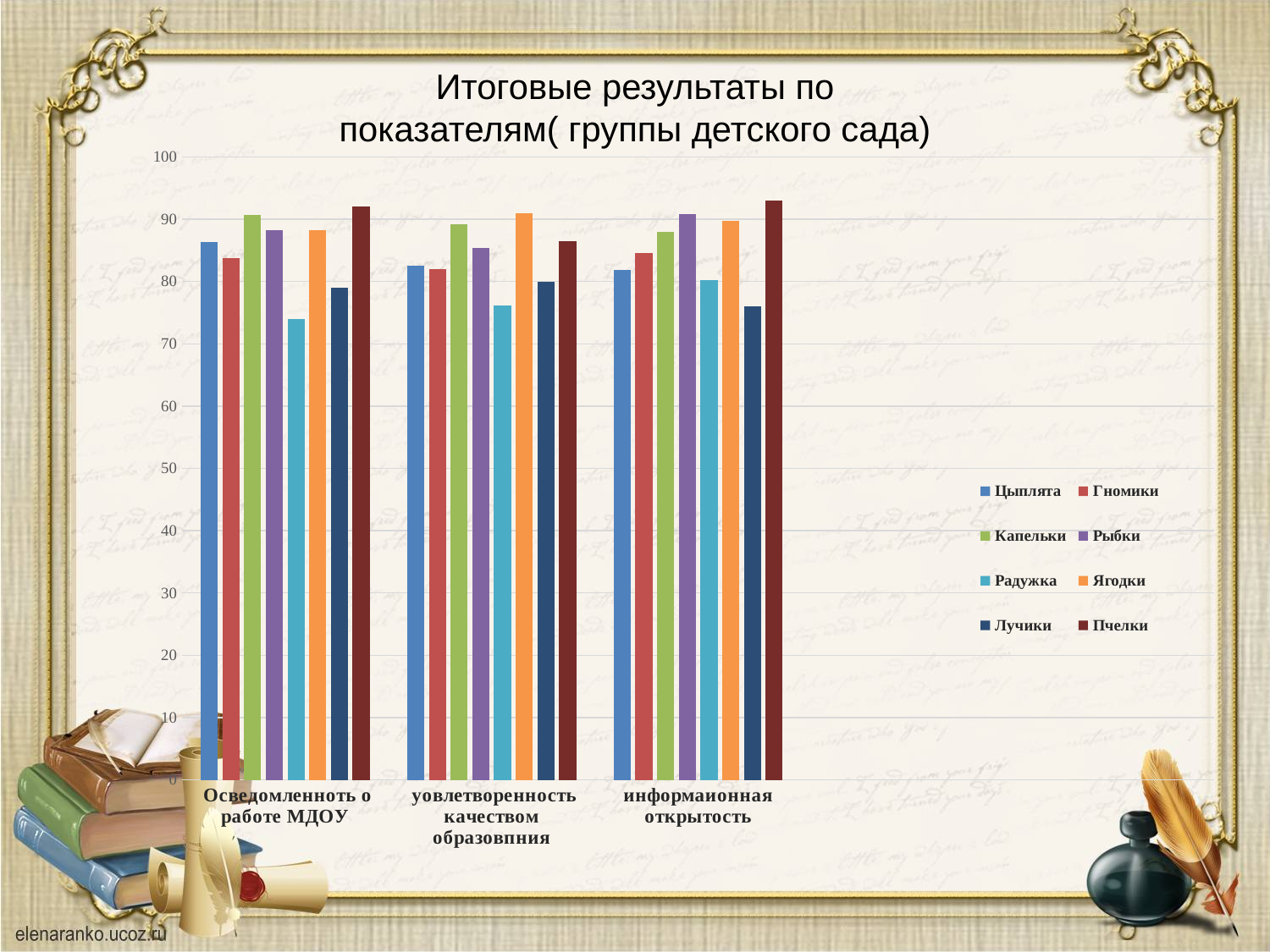
In the category информаионная открытость, which is larger: the value for Лучики or the value for Ягодки? Ягодки Is the value for Лучики in the category информаионная открытость greater or less than 80? less In the category Осведомленность о работе МДОУ, which is larger: the value for Радужка or the value for Пчелки? Пчелки Is the value for Пчелки in the category Осведомленность о работе МДОУ greater or less than 90? greater What kind of chart is shown on the slide? bar chart Which series has the lowest value in the category Осведомленность о работе МДОУ? Радужка Is the value for Радужка in the category Осведомленность о работе МДОУ greater or less than 80? less How many categories are shown on the x axis of the chart? 3 What is the title of the chart? Итоговые результаты по показателям( группы детского сада) Which series has the lowest value in the category информаионная открытость? Лучики How many series does the legend list? 8